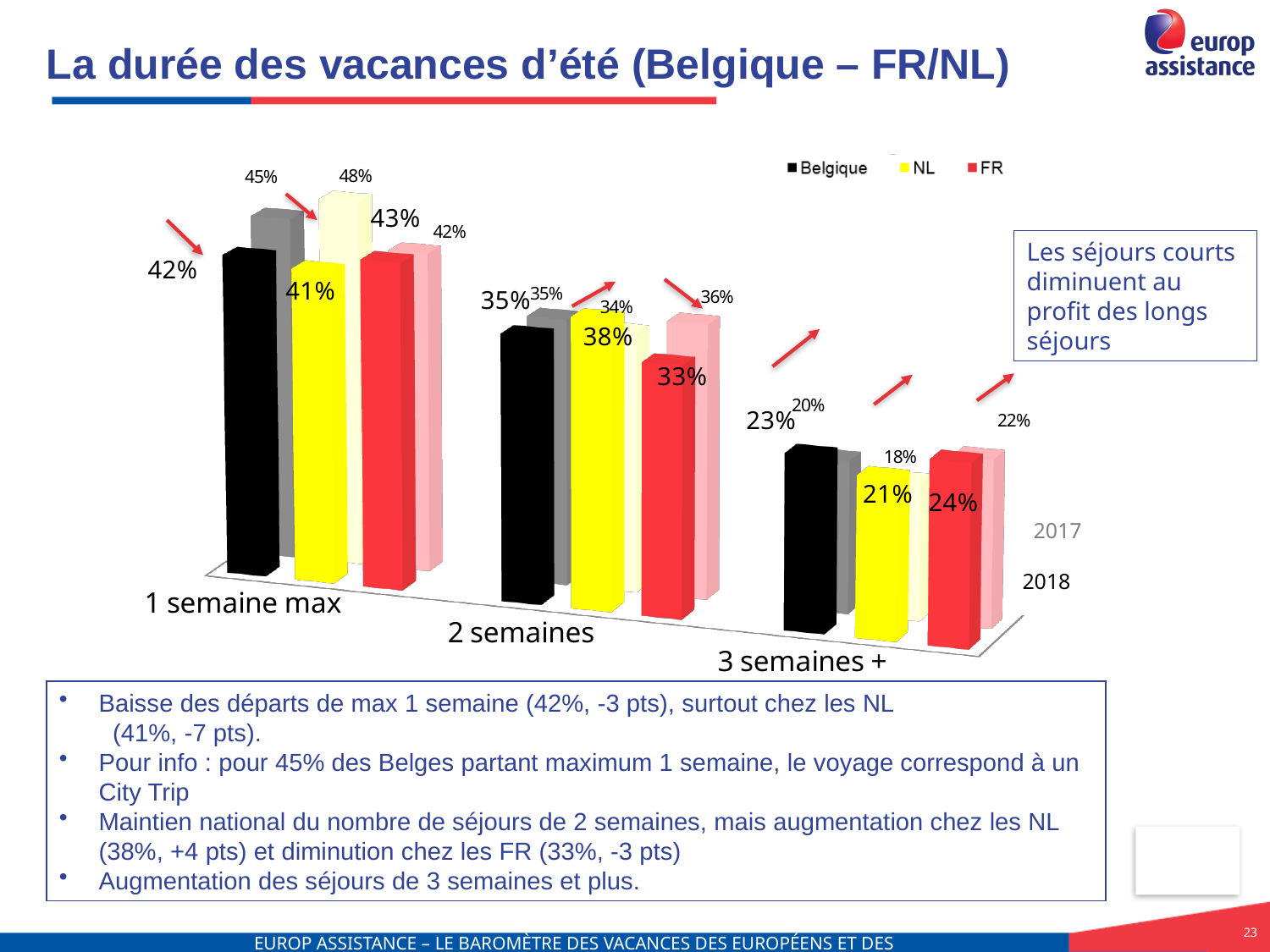
What is the 2017 value for NL in the '1 semaine max' category? 48% Which category has the lowest 2018 value for Belgique? 3 semaines + What is the 2018 value for Belgique in the '1 semaine max' category? 42% What is the 2018 value for NL in the '2 semaines' category? 38% Do the 2018 Belgique values rise or fall from '1 semaine max' to '3 semaines +'? fall What is the 2018 value for FR in the '3 semaines +' category? 24% What type of chart is shown on the slide? bar chart What is the difference between the 2017 and 2018 values for NL in the '1 semaine max' category? 7 pts How many series does the chart legend list? 3 Which is larger in the '3 semaines +' category for 2018: Belgique or NL? Belgique How many duration categories are shown along the x axis of the chart? 3 Which series has the highest 2018 value in the '2 semaines' category? NL